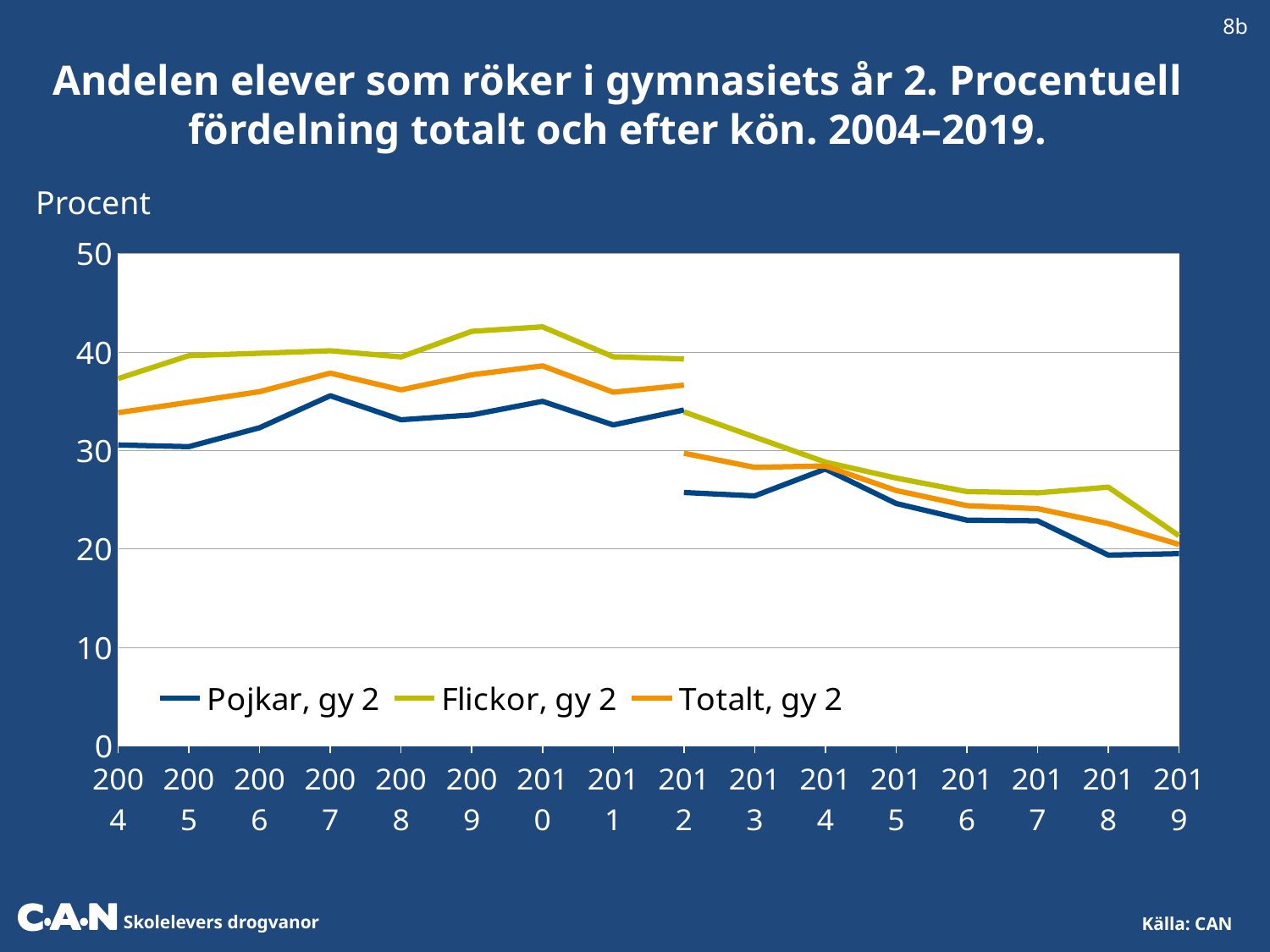
How many years are shown on the x axis? 16 In which year does the Flickor, gy 2 line reach its lowest value? 2019 Which series has the higher value in 2010, Pojkar, gy 2 or Flickor, gy 2? Flickor, gy 2 Is the value for Pojkar, gy 2 in 2013 greater or less than 30? less How many series does the legend list? 3 What is the label on the y axis of the chart? Procent Is the value for Flickor, gy 2 in 2010 greater or less than 40? greater Is the value for Totalt, gy 2 in 2007 greater or less than 30? greater Does the Pojkar, gy 2 line rise or fall from 2013 to 2019? Fall What kind of chart is shown on the slide? Line chart Which series is drawn with the dark blue line? Pojkar, gy 2 In which year does the Flickor, gy 2 line reach its highest value? 2010